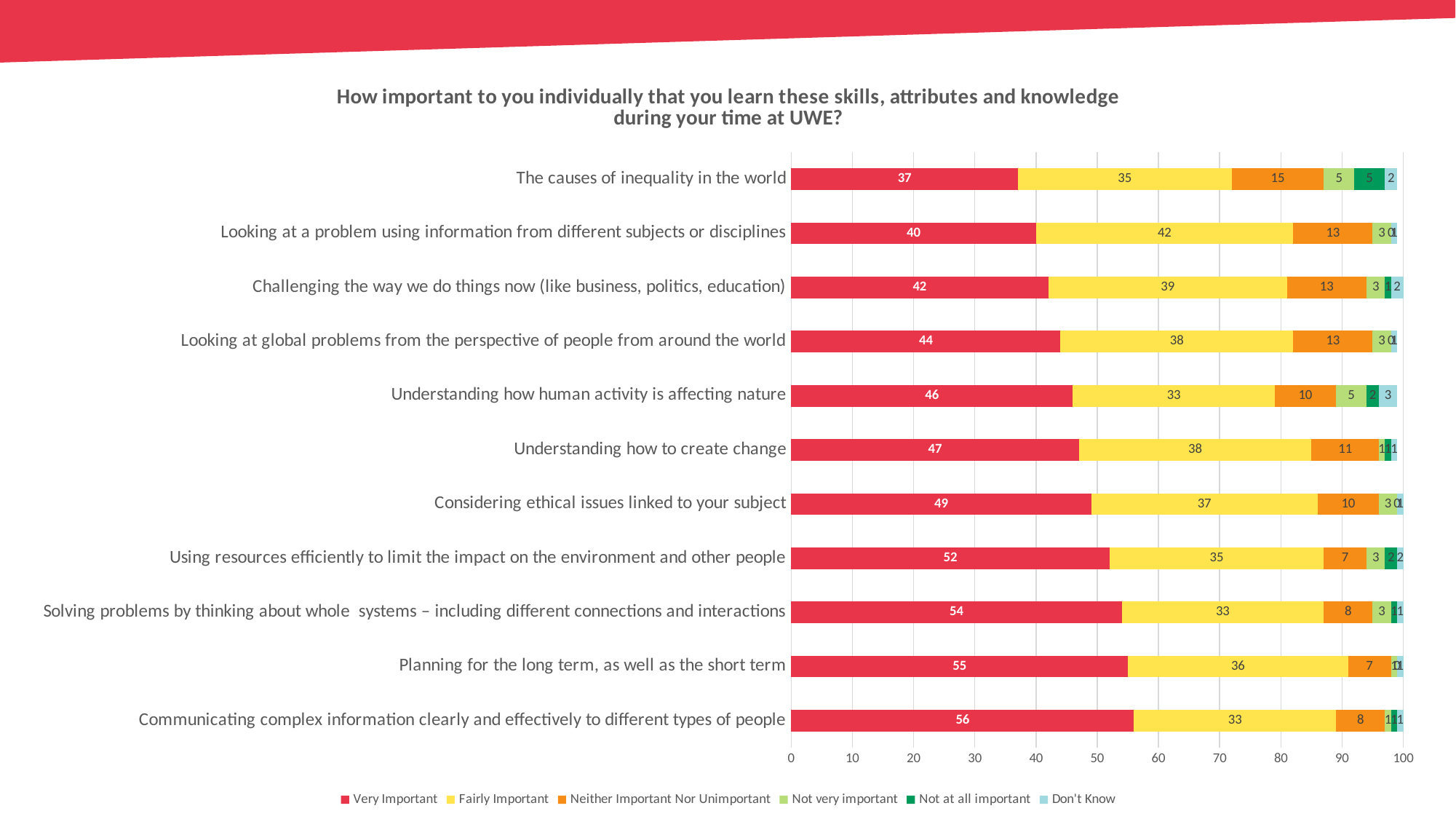
Which category has the lowest Very Important value? The causes of inequality in the world Which category has the highest Fairly Important value? Looking at a problem using information from different subjects or disciplines What is the Neither Important Nor Unimportant value for "Planning for the long term, as well as the short term"? 7 What is the difference between the Very Important values for "Communicating complex information clearly and effectively to different types of people" and "The causes of inequality in the world"? 19 Which has the larger Neither Important Nor Unimportant value: "The causes of inequality in the world" or "Understanding how human activity is affecting nature"? The causes of inequality in the world Which category has the highest Very Important value? Communicating complex information clearly and effectively to different types of people How many categories (skills/attributes) are plotted on the chart? 11 What is the title of the chart? How important to you individually that you learn these skills, attributes and knowledge during your time at UWE? What is the Very Important value for "The causes of inequality in the world"? 37 What is the Fairly Important value for "Looking at a problem using information from different subjects or disciplines"? 42 How many series does the legend list? 6 What kind of chart is shown on the slide? Stacked bar chart